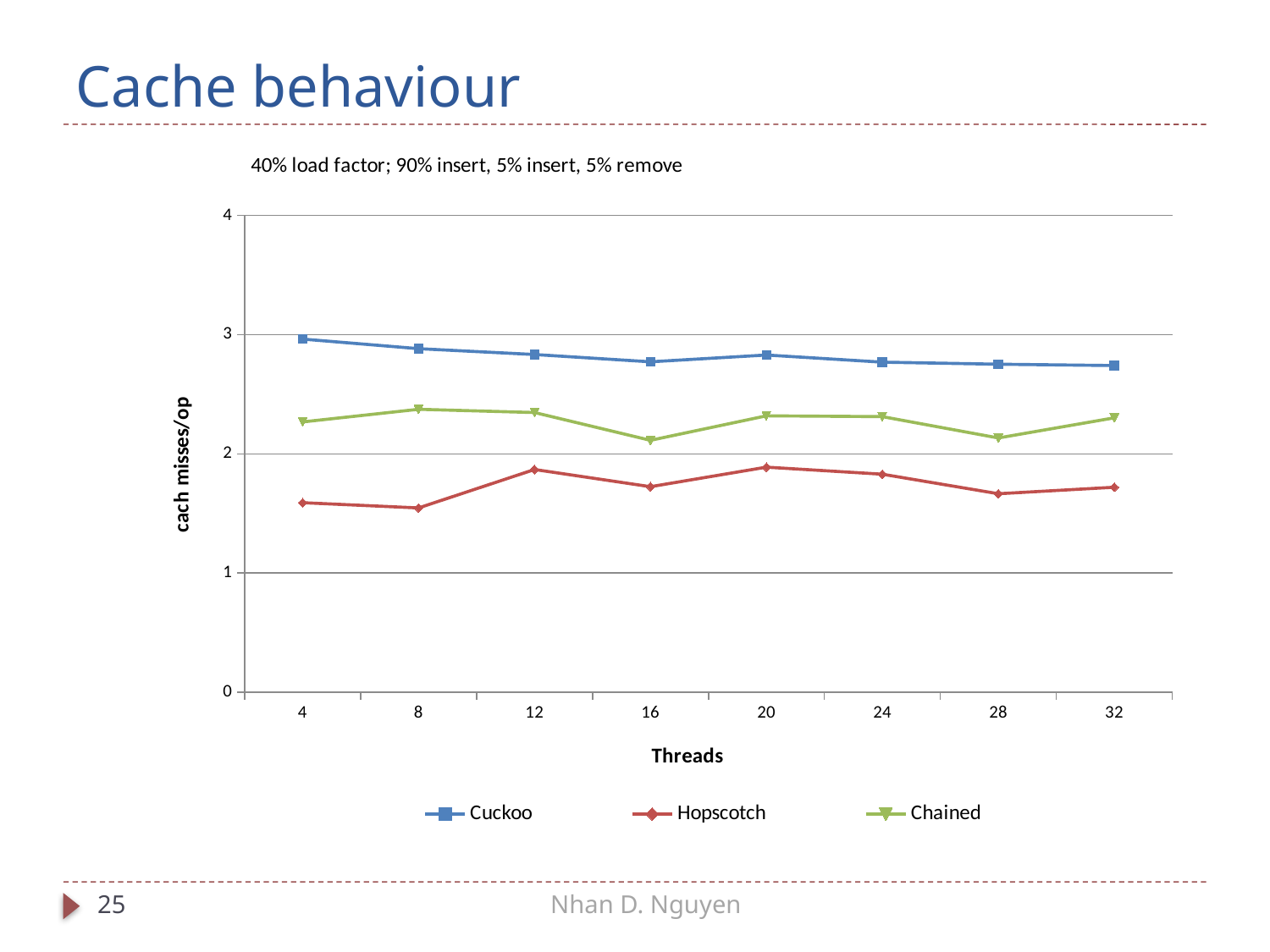
Is the value for Hopscotch at 8 threads greater or less than 2? less Is the value for Chained at 16 threads greater or less than 3? less Which series has the highest cache misses per operation across all thread counts? Cuckoo What is the label of the y axis? cach misses/op How many series does the legend list? 3 Is the value for Cuckoo at 4 threads greater or less than 2? greater How many thread counts are plotted along the x axis? 8 At 20 threads, which series has the larger value, Chained or Hopscotch? Chained Which series has the lowest cache misses per operation across all thread counts? Hopscotch Does the Cuckoo series generally rise or fall as the number of threads increases? fall What is the label of the x axis? Threads What kind of chart is shown on the slide? line chart